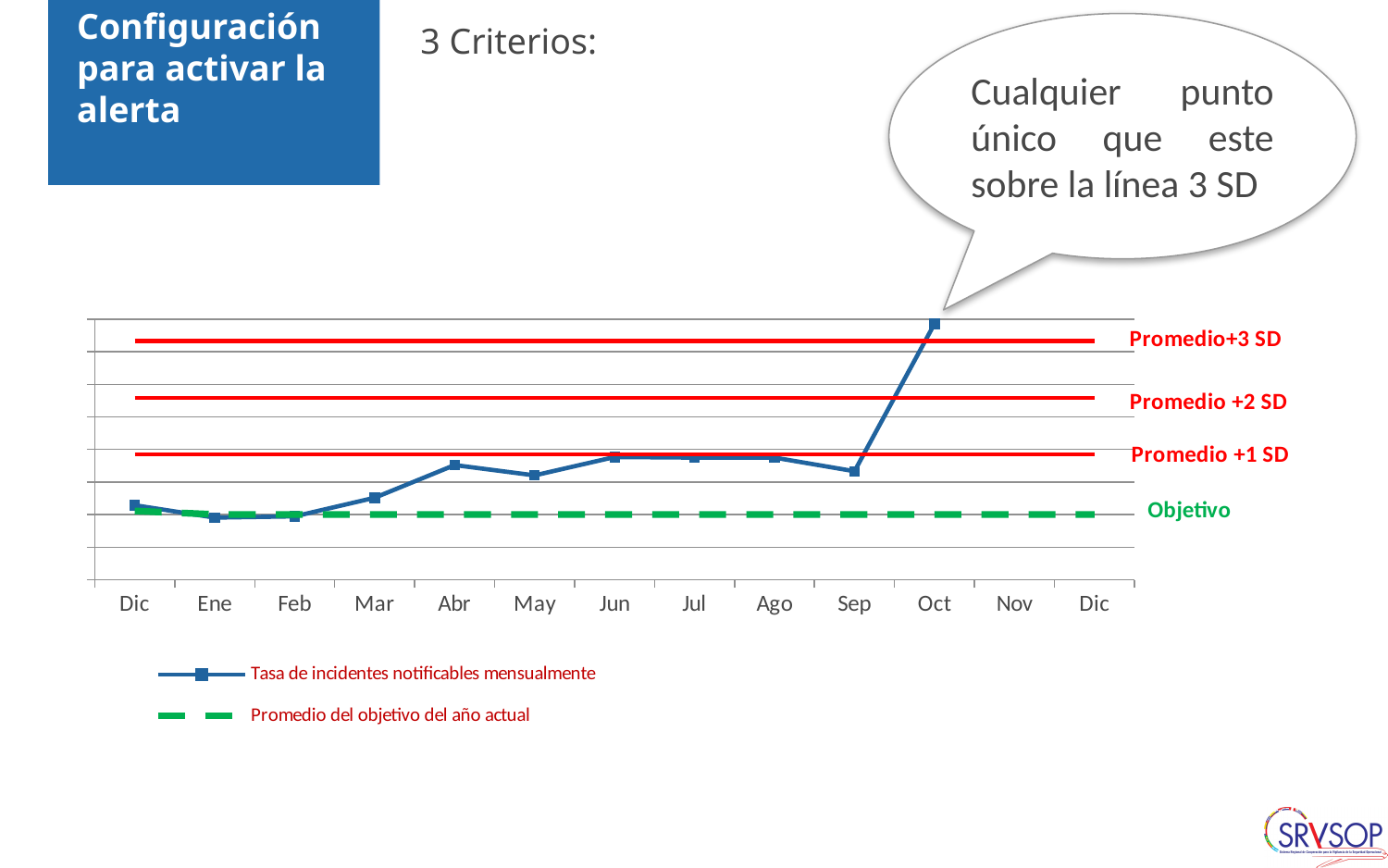
How many series does the chart legend list? 2 Is the value of the incident rate line higher in Oct or in Sep? Oct Is the value of the incident rate line higher in Abr or in Mar? Abr Is the value of the incident rate line higher in Jun or in May? Jun What is the label of the green dashed horizontal line on the chart? Objetivo Does the incident rate line rise or fall between Dic and Ene? fall In which month does the 'Tasa de incidentes notificables mensualmente' line reach its highest value? Oct What kind of chart is shown on the slide? line chart Does the incident rate line rise or fall between Sep and Oct? rise What is the name of the series drawn with the blue line and square markers? Tasa de incidentes notificables mensualmente How many month categories are shown on the x axis of the chart? 13